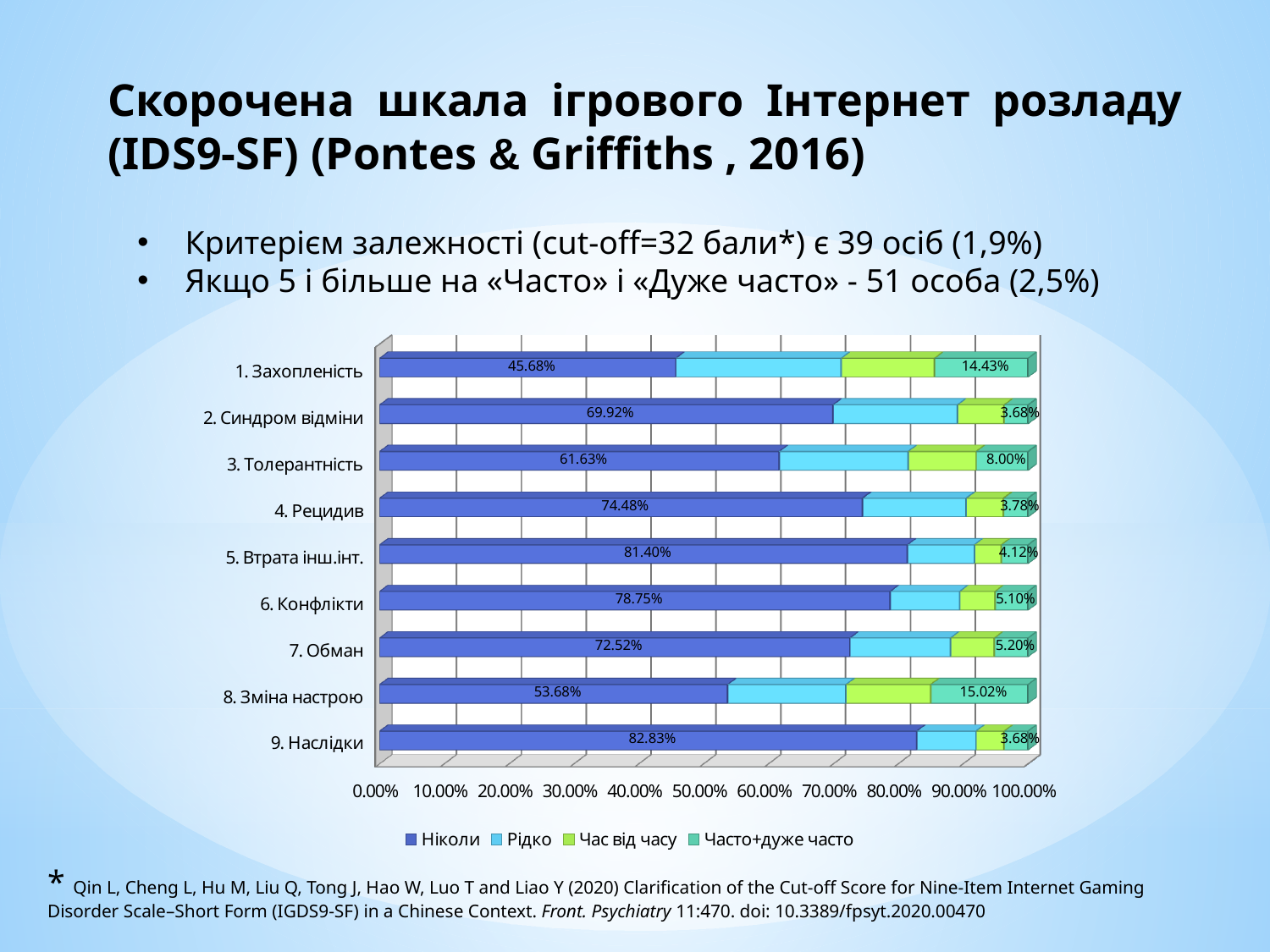
Which is larger: the "Ніколи" value for "4. Рецидив" or for "7. Обман"? 4. Рецидив What is the value of the "Ніколи" series for "5. Втрата інш.інт."? 81.40% Which category has the highest value for the "Ніколи" series? 9. Наслідки What is the value of the "Ніколи" series for "1. Захопленість"? 45.68% What is the value of the "Часто+дуже часто" series for "8. Зміна настрою"? 15.02% Which category has the highest value for the "Часто+дуже часто" series? 8. Зміна настрою How many categories are shown on the chart? 9 What kind of chart is shown on the slide? Stacked bar chart Which category has the lowest value for the "Ніколи" series? 1. Захопленість What is the difference between the "Ніколи" values for "9. Наслідки" and "1. Захопленість"? 37.15% How many series does the legend list? 4 Is the "Ніколи" value for "2. Синдром відміни" greater or less than 60%? greater